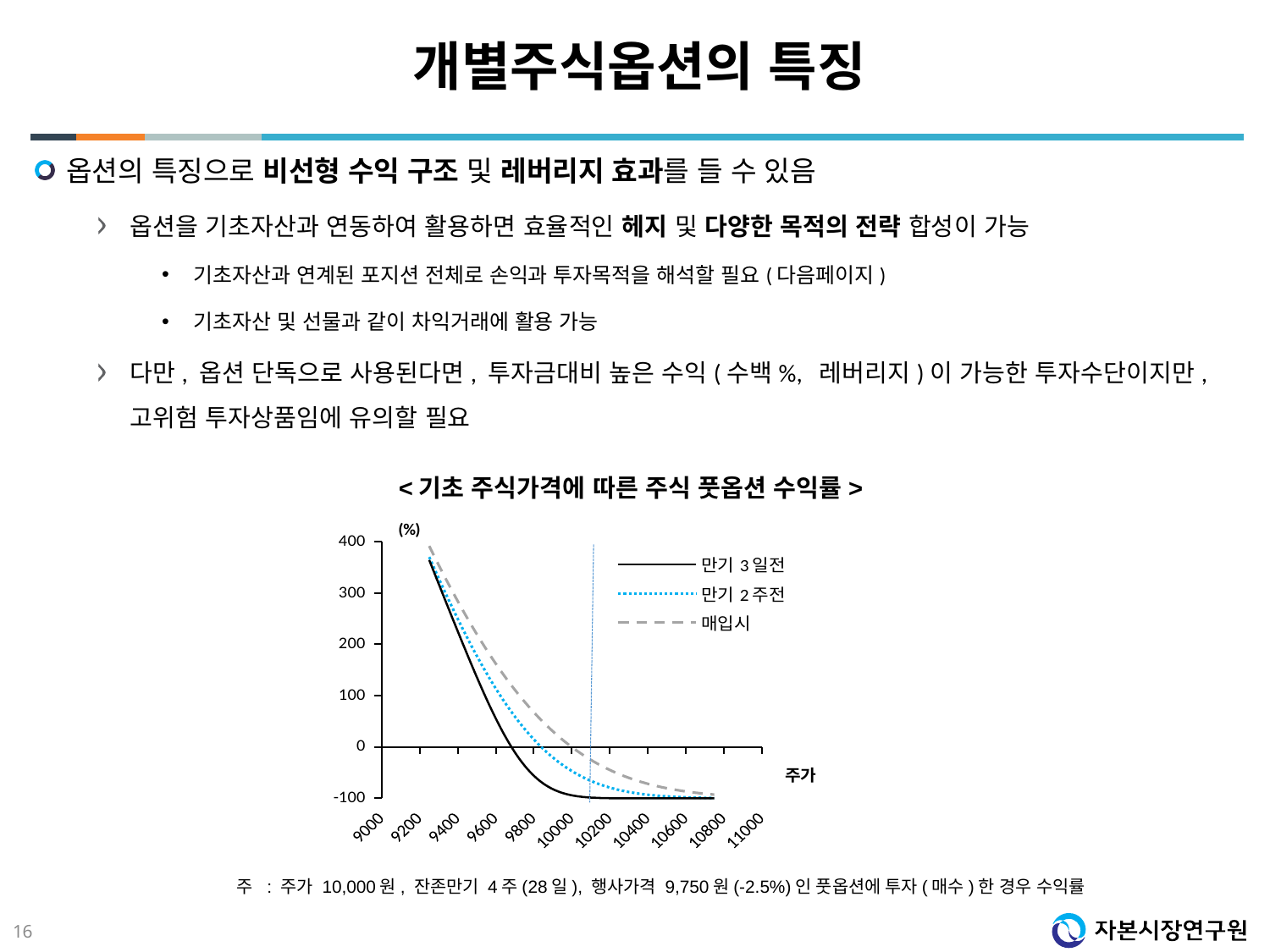
At 주가 10200, which series has the higher value, 매입시 or 만기 3일전? 매입시 What are the three series listed in the chart legend? 만기 3일전, 만기 2주전, 매입시 How many series does the legend of the chart list? 3 What is the highest value shown on the y axis of the chart? 400 Is the value for 만기 3일전 at 주가 10000 greater or less than 0? less What is the title of the chart? < 기초 주식가격에 따른 주식 풋옵션 수익률 > What kind of chart is shown on the slide? line chart Do the put option return values rise or fall as 주가 increases along the x axis? fall How many 주가 tick labels are shown on the x axis? 11 Is the value for 만기 3일전 at 주가 10400 greater or less than 0? less